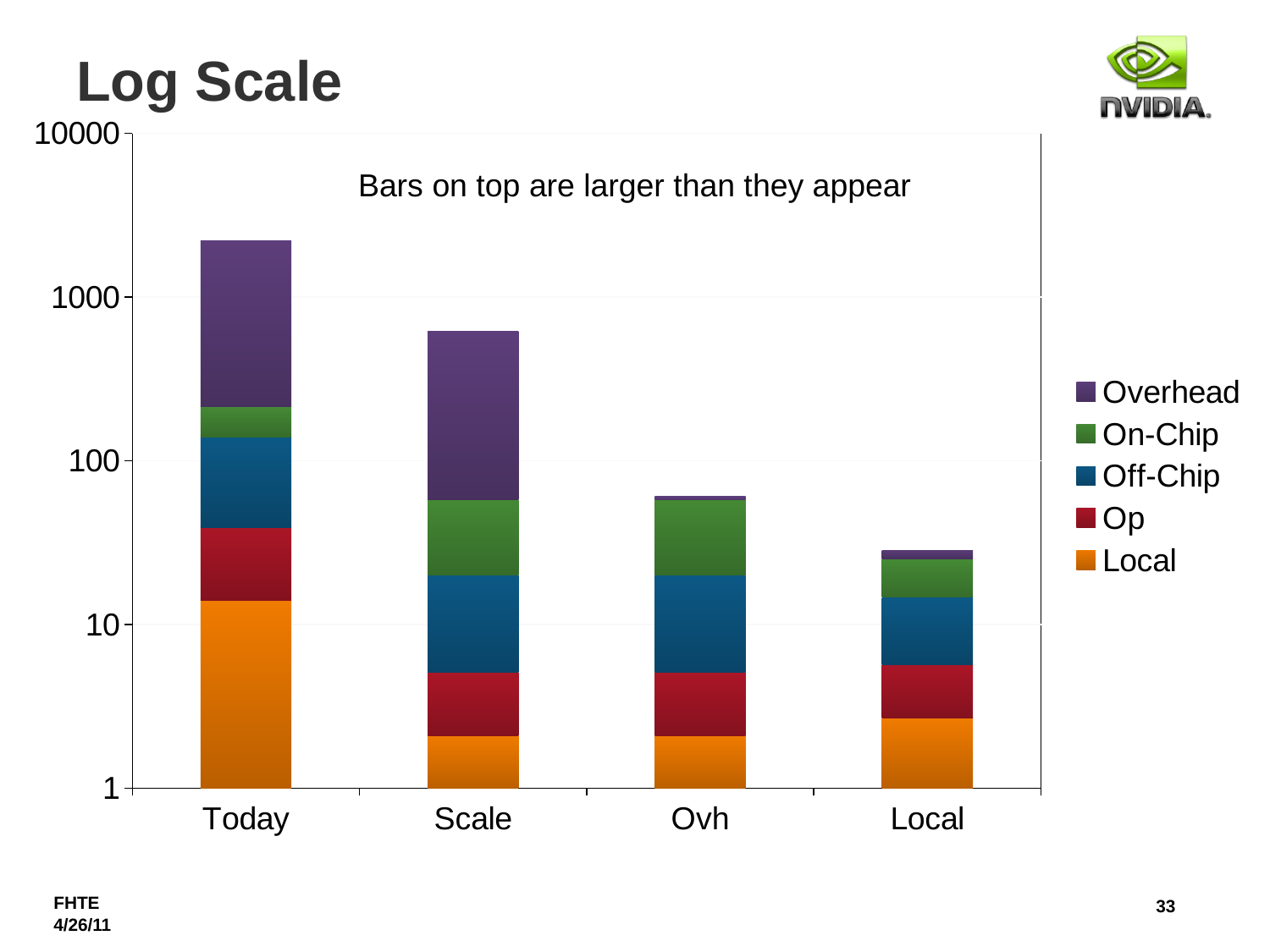
Which stacked bar is taller overall, Today or Scale? Today Do the total bar heights rise or fall moving from Today to Local along the x axis? Fall Which category has the shortest stacked bar overall? Local Is the total height of the Ovh bar greater or less than 100? less How many series does the legend list? 5 Which category has the tallest stacked bar overall? Today How many categories are shown along the x axis? 4 Is the total height of the Local bar greater or less than 10? greater Which series is shown at the top of each stacked bar in purple? Overhead Is the total height of the Today bar greater or less than 1000? greater What kind of chart is shown on the slide? Stacked bar chart